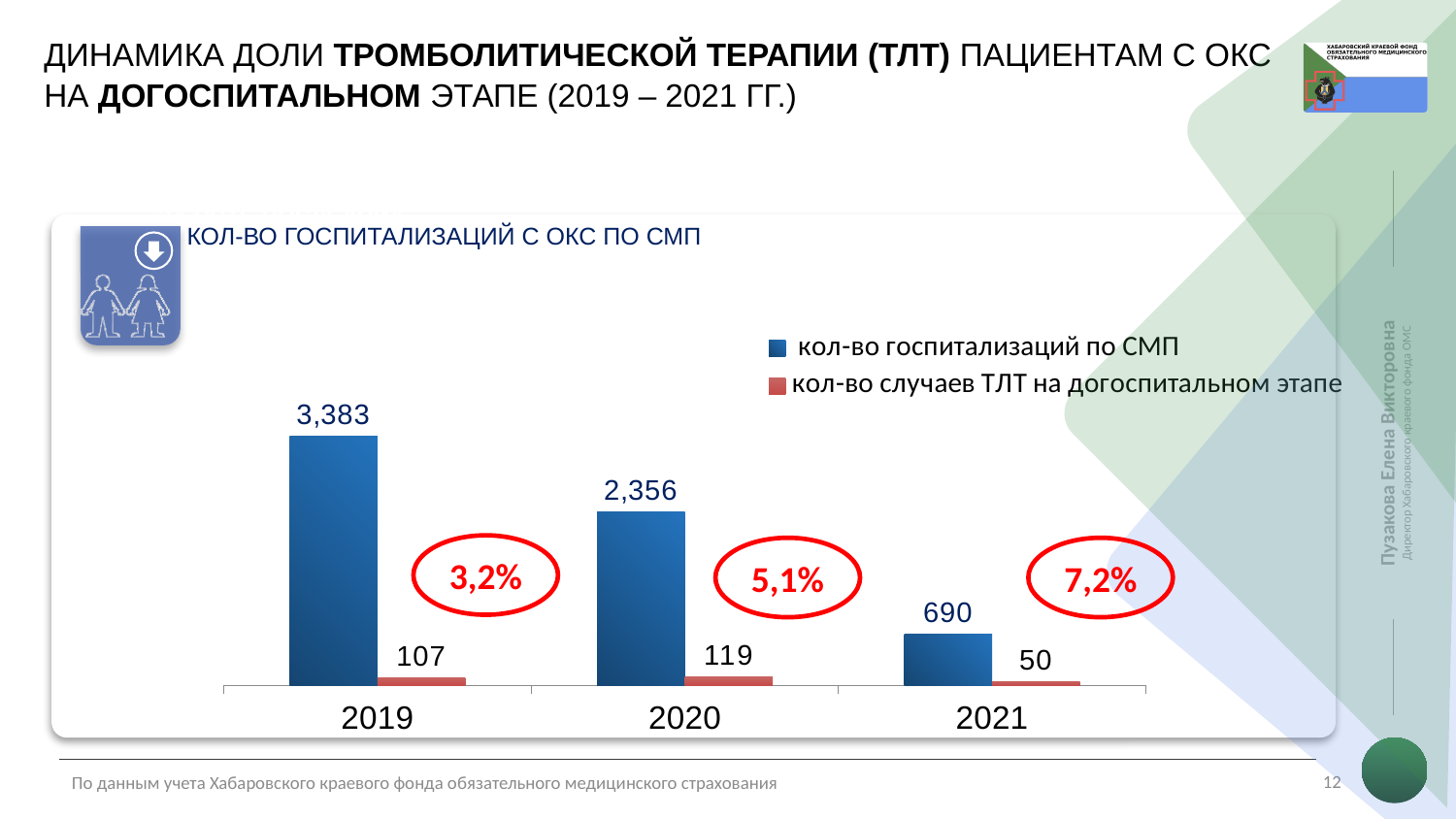
What is the number of hospitalizations by SMP (кол-во госпитализаций по СМП) in 2019? 3,383 What is the number of hospitalizations by SMP (кол-во госпитализаций по СМП) in 2021? 690 What is the difference between the number of hospitalizations by SMP in 2019 and in 2020? 1,027 How many cases of TLT at the prehospital stage (кол-во случаев ТЛТ на догоспитальном этапе) were there in 2020? 119 Do the hospitalizations by SMP rise or fall from 2019 to 2021? Fall What percentage is shown in the red oval for 2021? 7,2% What kind of chart is shown on the slide? Bar chart How many years (categories) are shown on the x axis of the chart? 3 How many series does the chart legend list? 2 Which year has the highest number of hospitalizations by SMP? 2019 Which year has the lowest number of TLT cases at the prehospital stage? 2021 Which is larger: the number of TLT cases at the prehospital stage in 2019 or in 2020? 2020